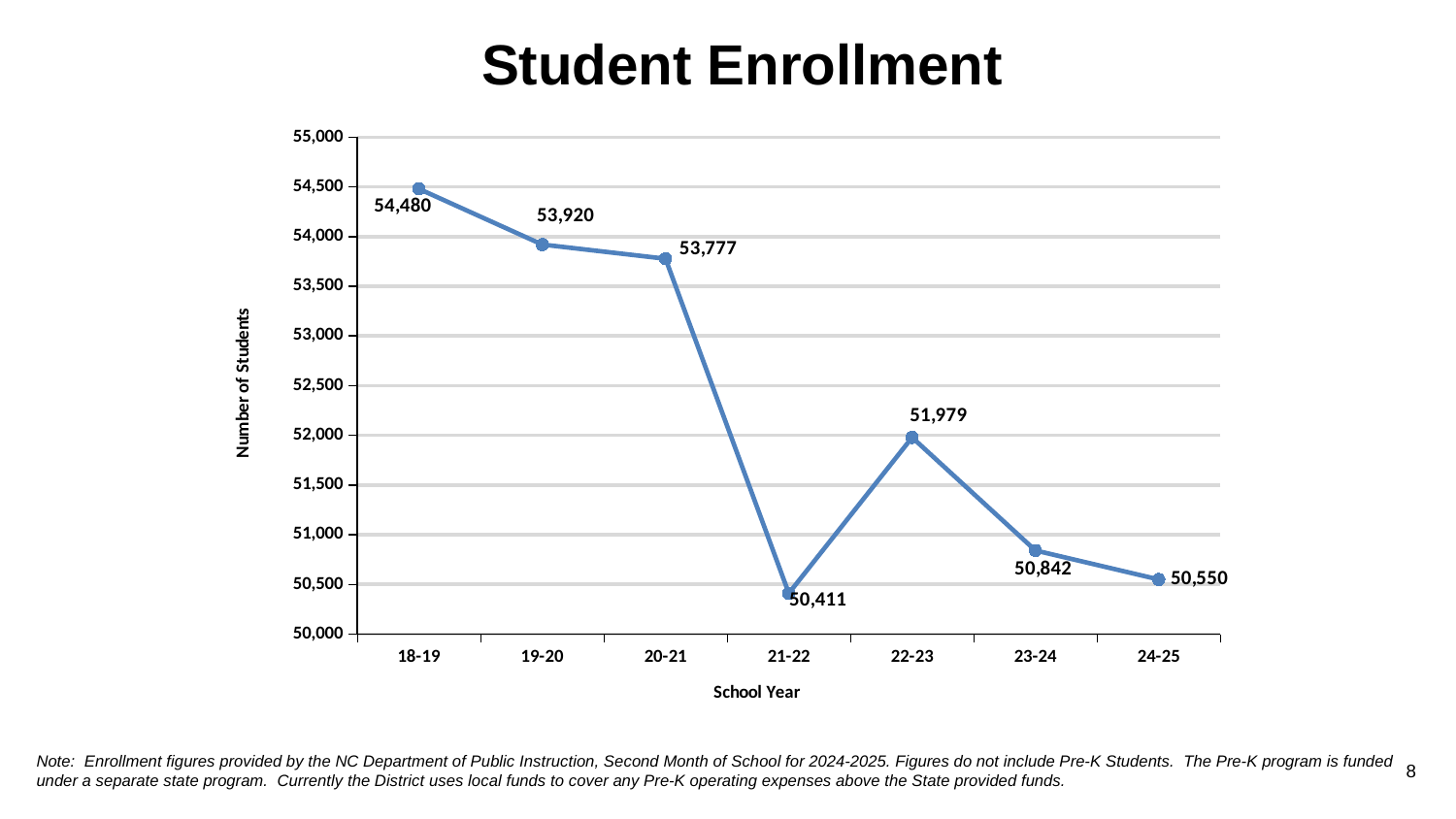
What kind of chart is shown on the slide? line chart What is the difference in enrollment between the 22-23 and 21-22 school years? 1,568 How many school years are plotted on the chart? 7 What is the student enrollment for the 21-22 school year? 50,411 Which school year has the lowest student enrollment? 21-22 Which school year has the highest student enrollment? 18-19 What is the student enrollment for the 18-19 school year? 54,480 What is the student enrollment for the 24-25 school year? 50,550 Which school year has higher enrollment, 22-23 or 23-24? 22-23 What is the difference in enrollment between the 18-19 and 24-25 school years? 3,930 What is the label of the y axis? Number of Students Is the enrollment for the 20-21 school year greater or less than 53,500? greater